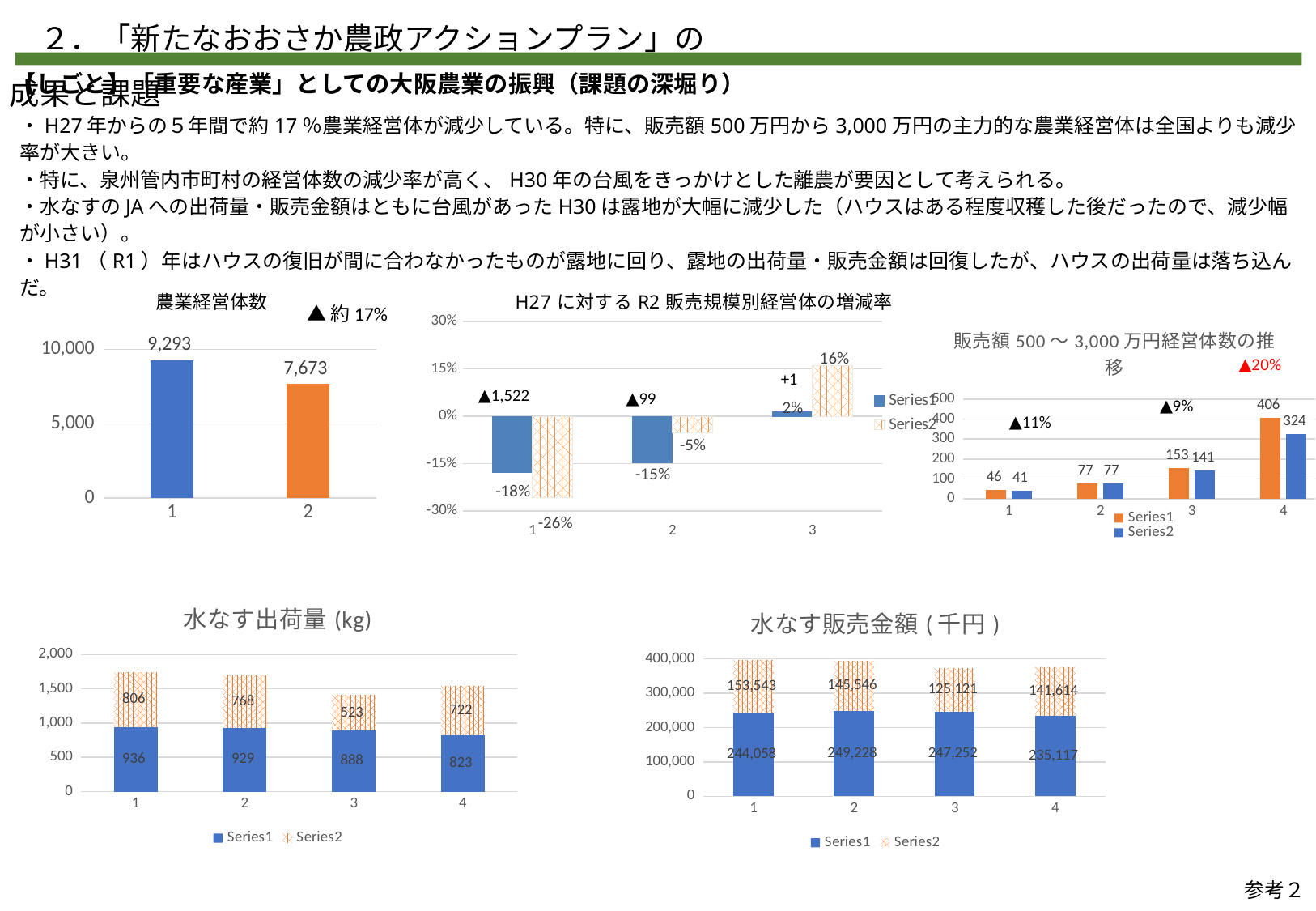
In the 水なす販売金額(千円) chart, what is the Series1 value for category 2? 249,228 What kind of chart is the 水なす販売金額(千円) chart? stacked bar chart In the H27に対するR2販売規模別経営体の増減率 chart, how many series does the legend list? 2 In the 販売額500～3,000万円経営体数の推移 chart, which category has the lowest Series2 value? 1 In the 農業経営体数 chart, what is the difference between the values for category 1 and category 2? 1,620 In the 水なす出荷量(kg) chart, what is the total of the stacked bar for category 3? 1,411 In the H27に対するR2販売規模別経営体の増減率 chart, what is the Series1 value for category 3? 2% In the 販売額500～3,000万円経営体数の推移 chart, what is the Series1 value for category 4? 406 In the H27に対するR2販売規模別経営体の増減率 chart, what is the Series2 value for category 1? -26% In the 農業経営体数 chart, what is the value for category 1? 9,293 In the 水なす出荷量(kg) chart, which category has the lowest Series2 value? 3 In the 水なす販売金額(千円) chart, is the Series2 value for category 1 larger or smaller than the Series2 value for category 3? larger